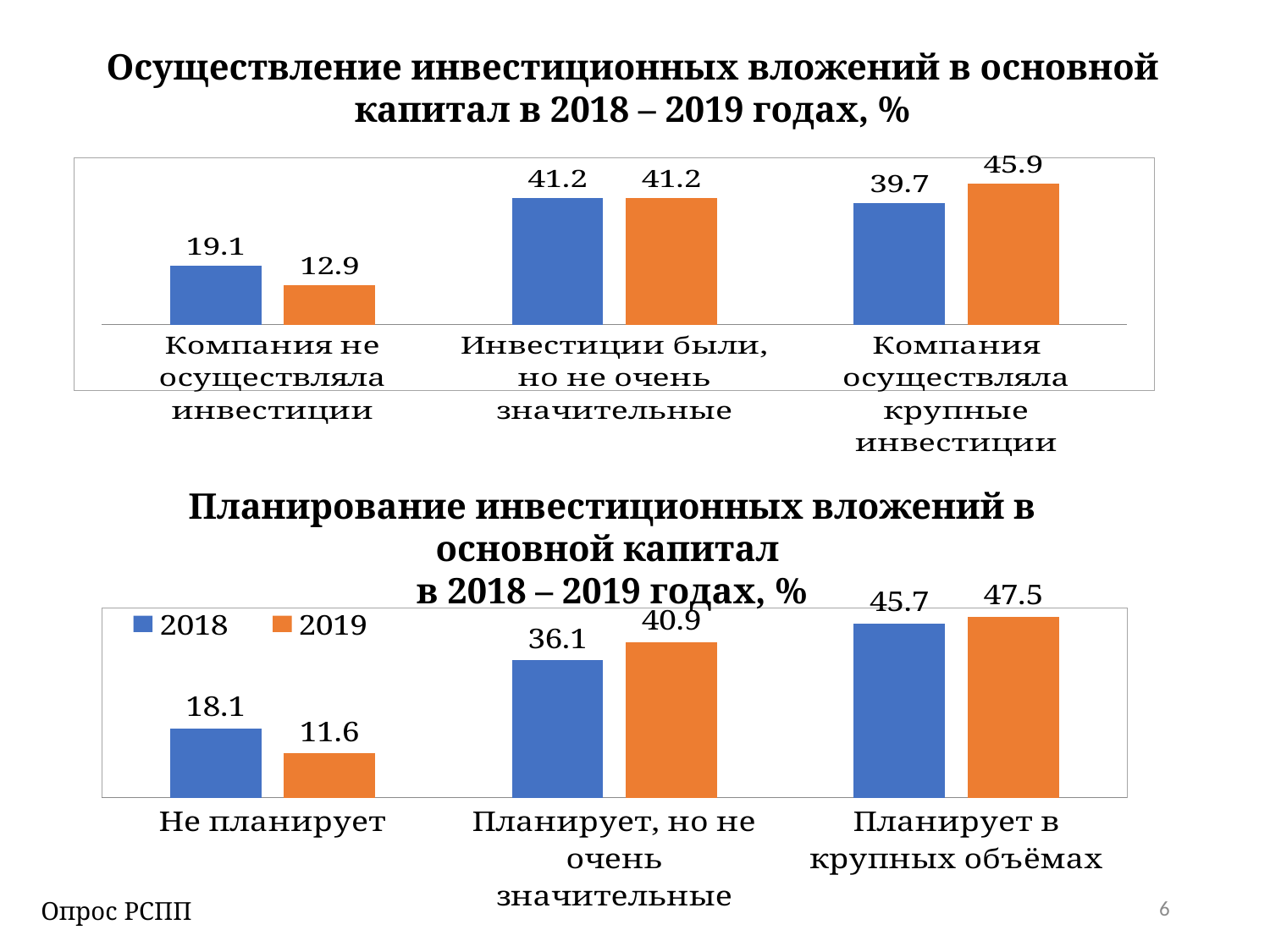
In the bottom chart (Планирование инвестиционных вложений), which category has the highest 2019 value? Планирует в крупных объёмах What type of chart is the bottom chart (Планирование инвестиционных вложений)? Bar chart In the top chart (Осуществление инвестиционных вложений), how many categories are shown on the x axis? 3 In the bottom chart (Планирование инвестиционных вложений), how many series does the legend list? 2 In the top chart (Осуществление инвестиционных вложений), which category has the lowest orange bar? Компания не осуществляла инвестиции In the bottom chart (Планирование инвестиционных вложений), what is the 2018 value for "Планирует, но не очень значительные"? 36.1 In the top chart (Осуществление инвестиционных вложений), what is the value of the blue bar for "Компания не осуществляла инвестиции"? 19.1 In the top chart (Осуществление инвестиционных вложений), what is the value of the orange bar for "Компания осуществляла крупные инвестиции"? 45.9 In the bottom chart (Планирование инвестиционных вложений), which is larger for "Планирует, но не очень значительные": the 2018 value or the 2019 value? 2019 In the bottom chart (Планирование инвестиционных вложений), what is the difference between the 2019 and 2018 values for "Планирует в крупных объёмах"? 1.8 In the top chart (Осуществление инвестиционных вложений), what is the difference between the blue and orange bars for "Компания не осуществляла инвестиции"? 6.2 In the bottom chart (Планирование инвестиционных вложений), what is the 2019 value for "Не планирует"? 11.6